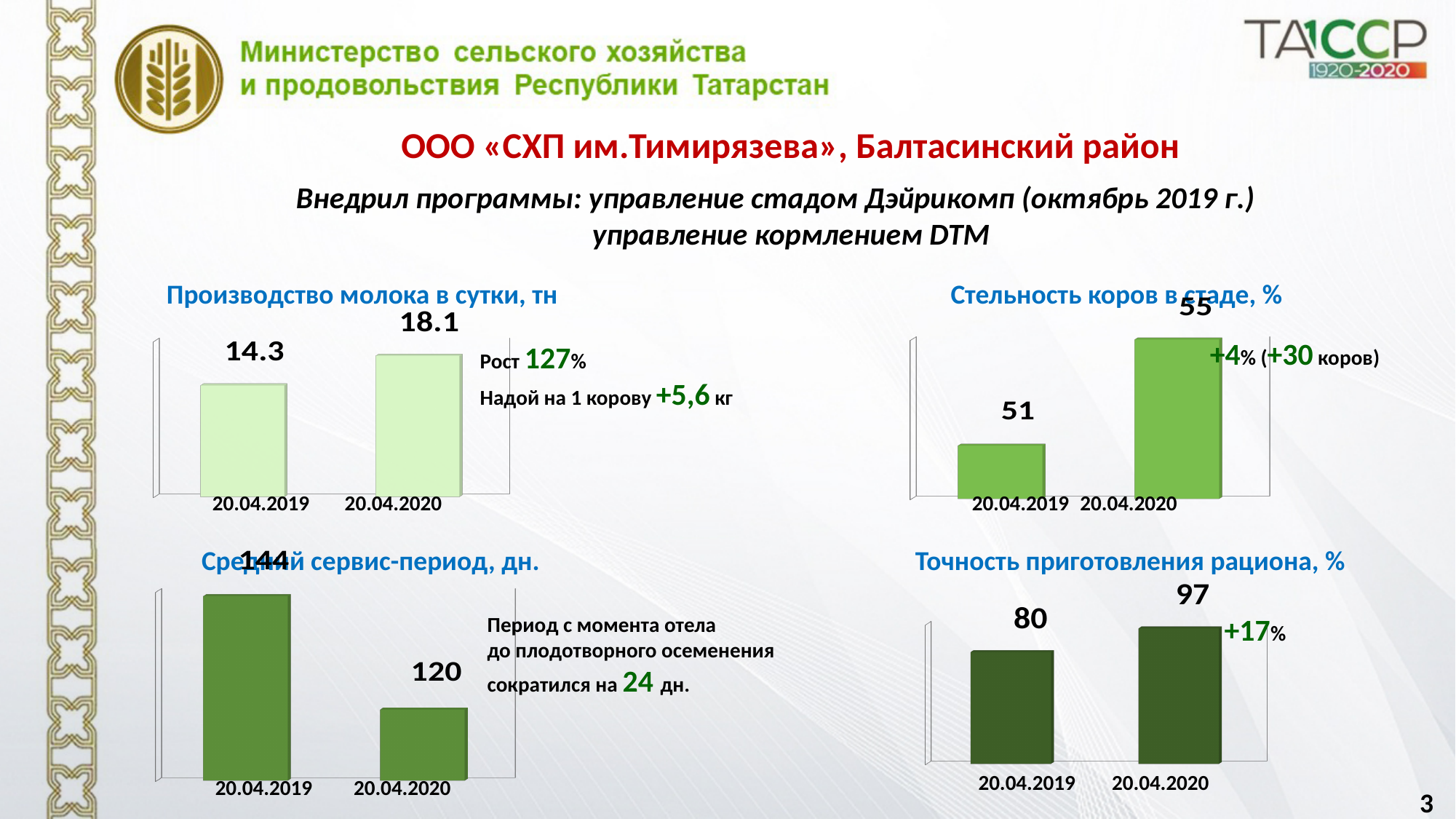
In the chart titled «Производство молока в сутки, тн», what is the value for 20.04.2020? 18.1 What type of chart is the chart titled «Средний сервис-период, дн.»? bar chart In the chart titled «Производство молока в сутки, тн», what is the difference between the 20.04.2020 and 20.04.2019 values? 3.8 In the chart titled «Стельность коров в стаде, %», which date has the higher value? 20.04.2020 In the chart titled «Стельность коров в стаде, %», what is the value for 20.04.2019? 51 In the chart titled «Средний сервис-период, дн.», what is the value for 20.04.2019? 144 How many bars are in the chart titled «Точность приготовления рациона, %»? 2 In the chart titled «Средний сервис-период, дн.», do the values rise or fall from 20.04.2019 to 20.04.2020? fall In the chart titled «Производство молока в сутки, тн», what is the value for 20.04.2019? 14.3 In the chart titled «Стельность коров в стаде, %», what is the difference between the two bars? 4 In the chart titled «Точность приготовления рациона, %», what is the value for 20.04.2020? 97 In the chart titled «Точность приготовления рациона, %», what is the difference between the 20.04.2020 and 20.04.2019 values? 17